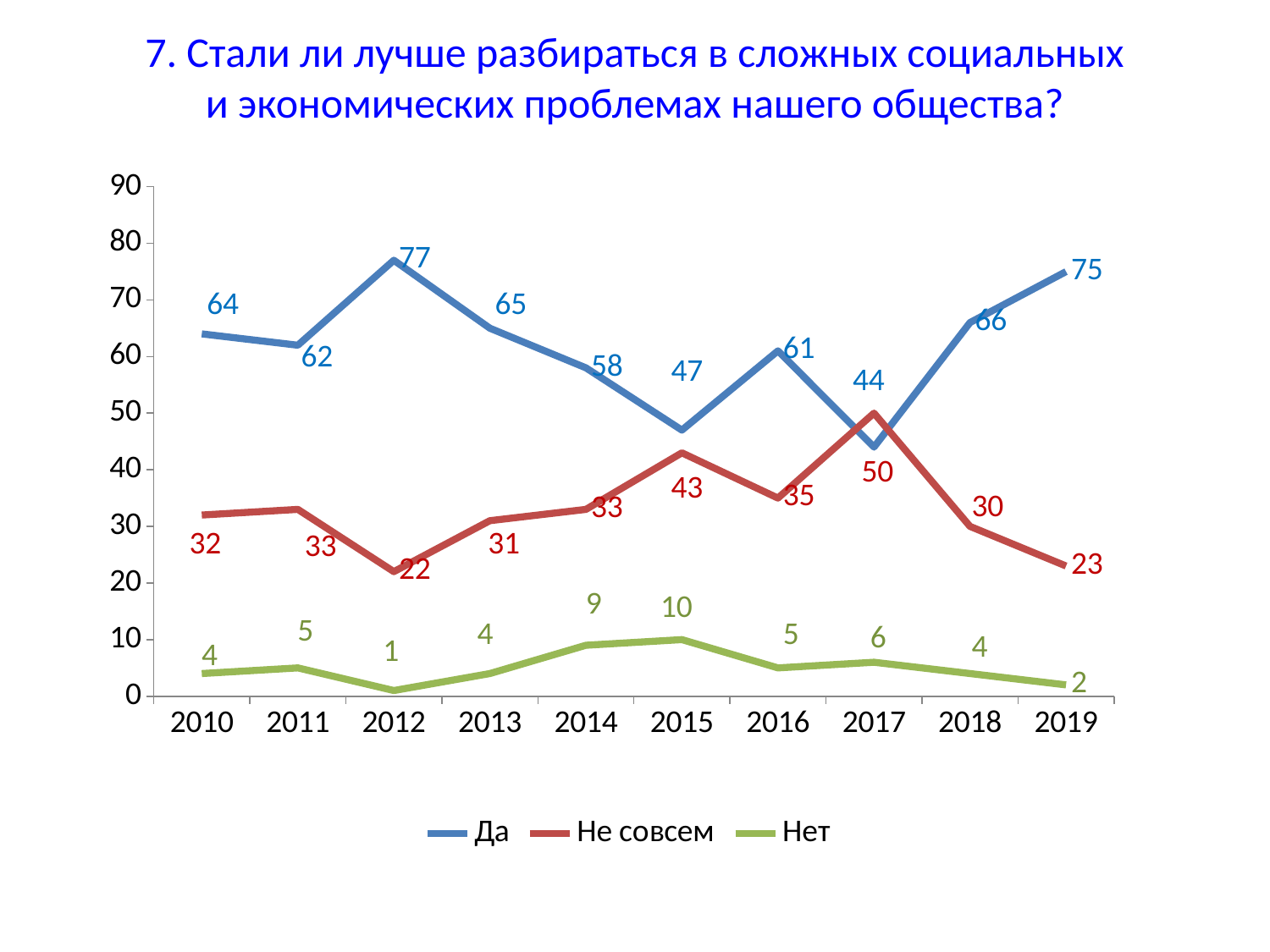
What kind of chart is shown on the slide? Line chart What value does the "Не совсем" series have in 2017? 50 What is the difference between the "Да" value in 2019 and the "Да" value in 2018? 9 What value does the "Да" series have in 2012? 77 Which series has the larger value in 2017, "Да" or "Не совсем"? Не совсем How many years are shown on the x axis? 10 What value does the "Нет" series have in 2015? 10 In which year is the "Не совсем" series at its highest? 2017 How many series does the legend list? 3 In which year is the "Нет" series at its lowest? 2012 Does the "Не совсем" series rise or fall from 2017 to 2019? Fall In which year is the "Да" series at its lowest? 2017